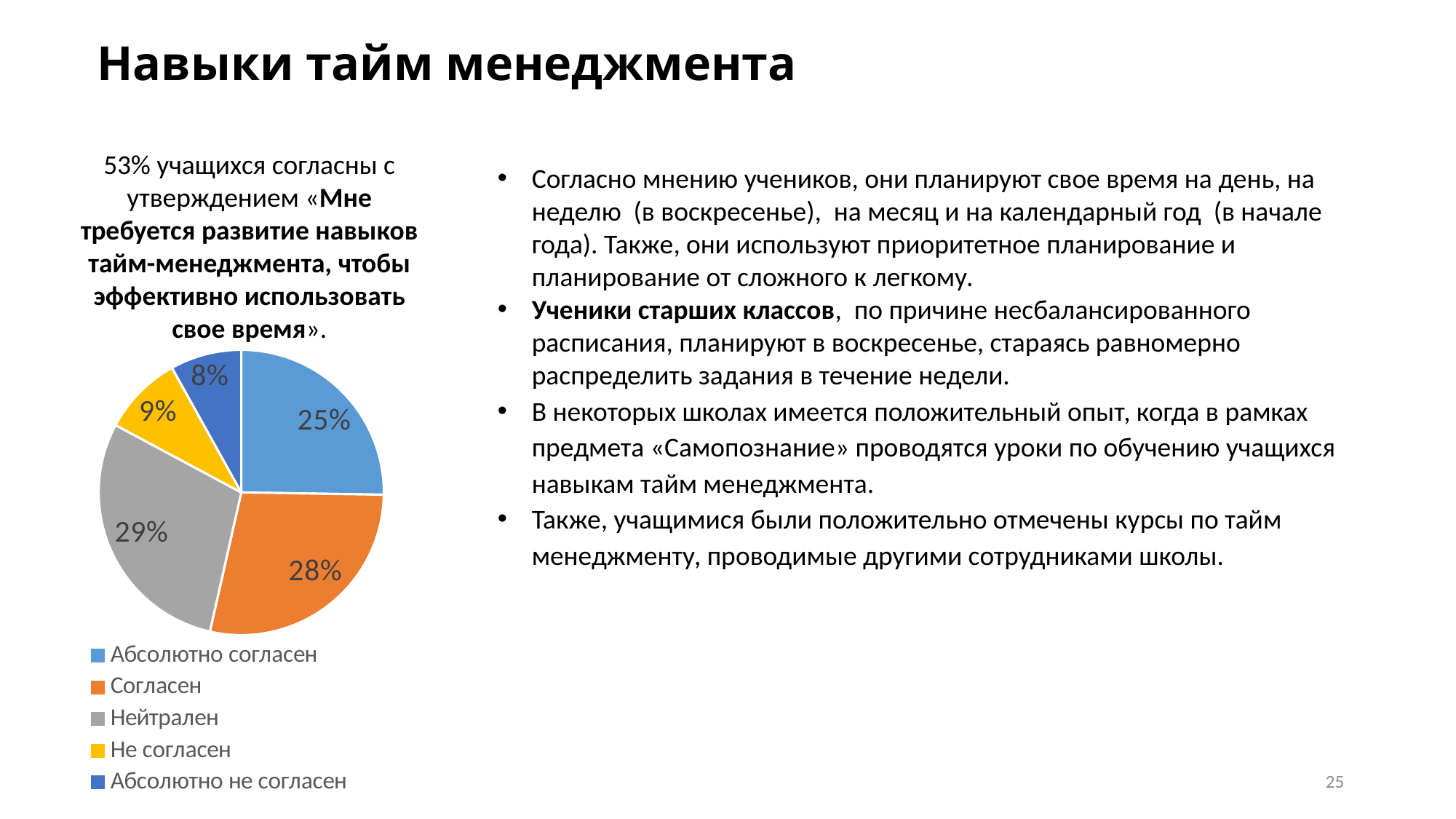
What is the value for "Абсолютно не согласен" in the pie chart? 8% Which is larger, the slice for "Абсолютно согласен" or the slice for "Не согласен"? Абсолютно согласен What is the value for "Согласен" in the pie chart? 28% What is the value for "Не согласен" in the pie chart? 9% How many categories does the pie chart have? 5 What is the value for "Нейтрален" in the pie chart? 29% What share of the pie does "Абсолютно согласен" take? 25% Which category has the smallest slice of the pie? Абсолютно не согласен What kind of chart is shown on the slide? pie chart Which category has the largest slice of the pie? Нейтрален What is the difference between the values for "Согласен" and "Не согласен"? 19% What colour is the slice for "Согласен" in the pie chart? orange